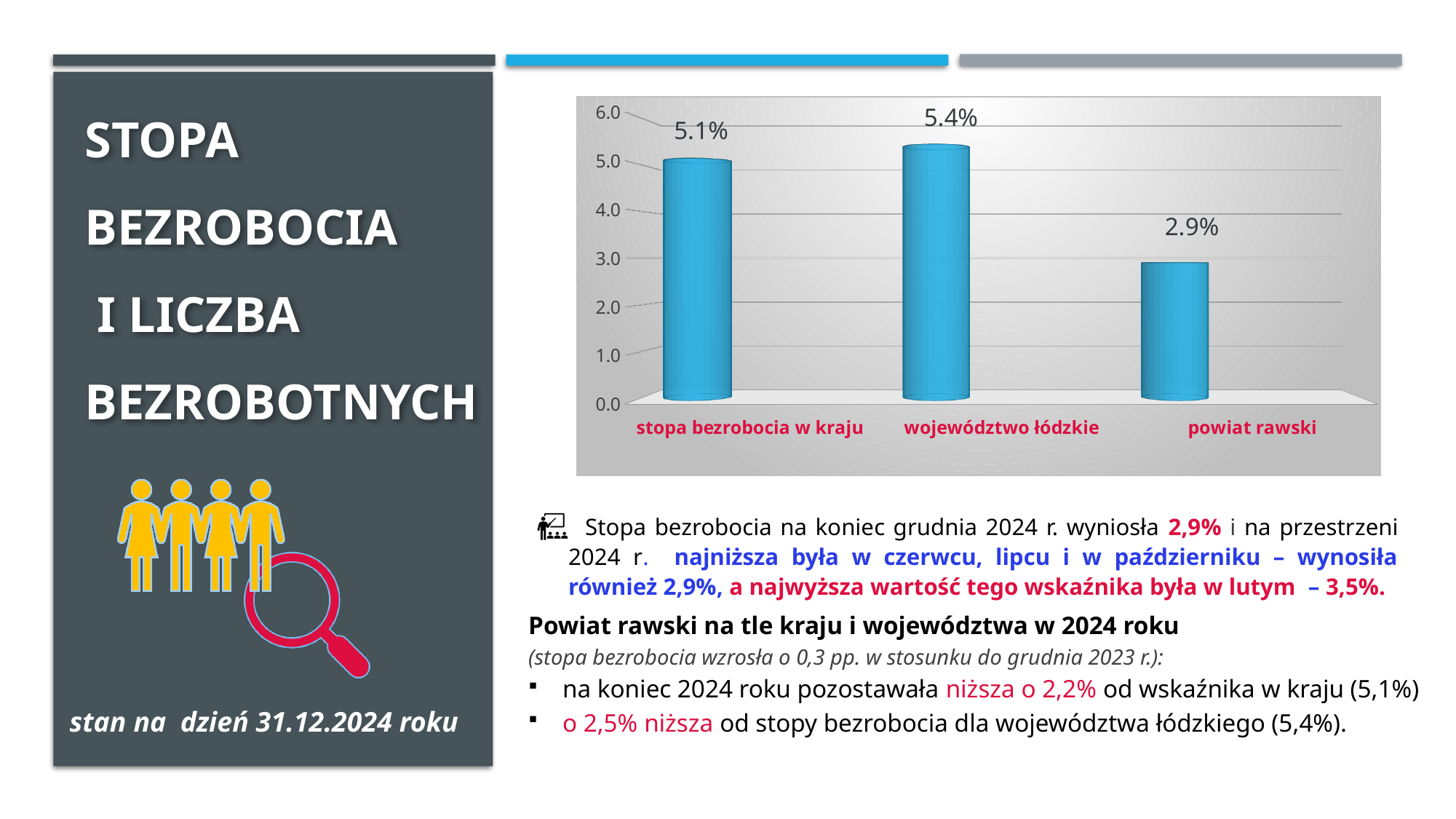
What is the difference between the values for województwo łódzkie and powiat rawski? 2.5% Which is larger, the value for stopa bezrobocia w kraju or the value for powiat rawski? stopa bezrobocia w kraju What is the value for województwo łódzkie? 5.4% Which category has the highest value? województwo łódzkie Which category has the lowest value? powiat rawski What kind of chart is shown on the slide? bar chart What is the value for stopa bezrobocia w kraju? 5.1% Is the value for powiat rawski greater or less than 3.0? less How many categories are shown in the chart? 3 What is the difference between the values for stopa bezrobocia w kraju and powiat rawski? 2.2% What is the value for powiat rawski? 2.9% What colour are the bars in the chart? blue